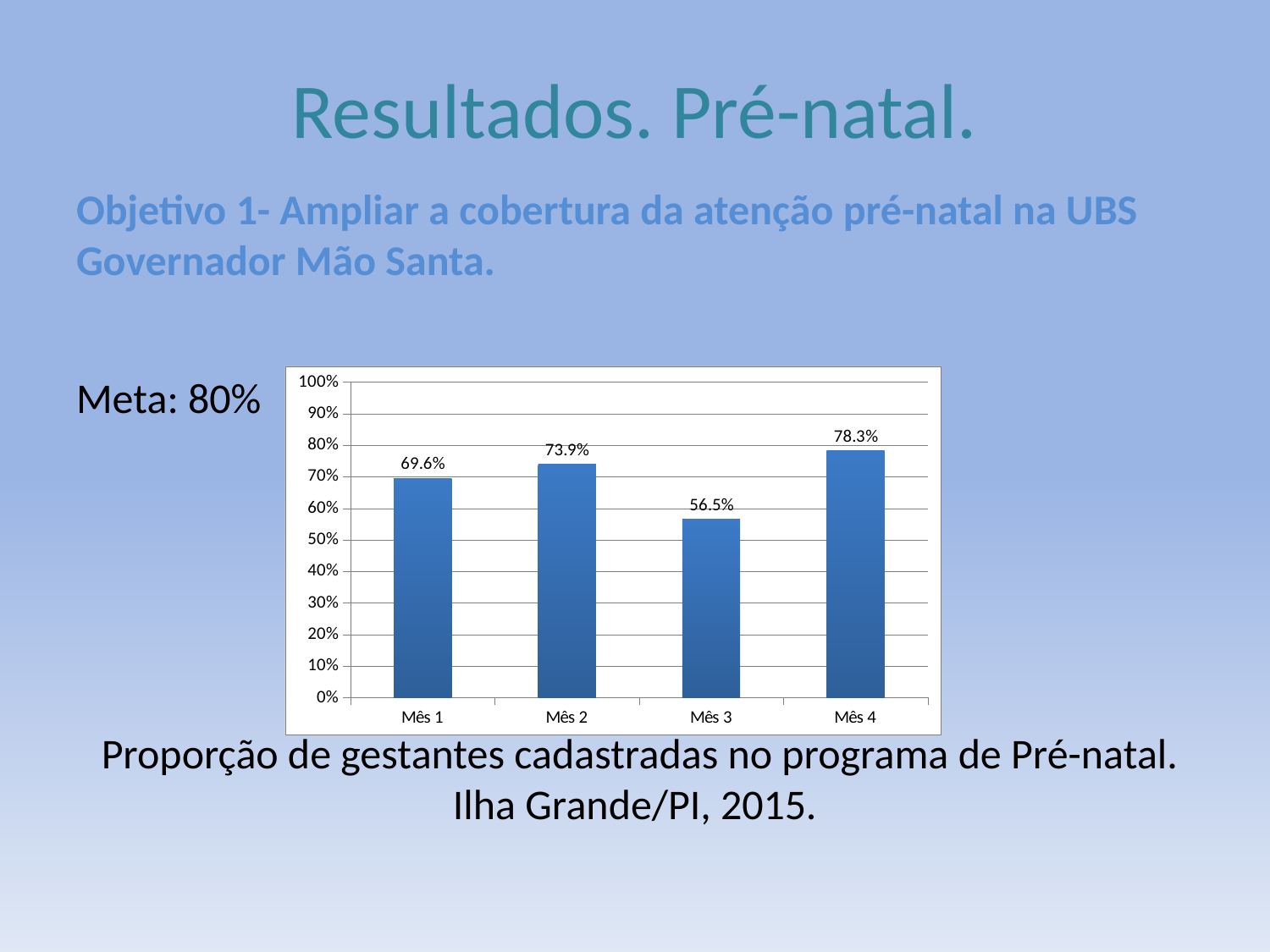
What is the difference between the values for Mês 2 and Mês 1? 4.3% Is the value for Mês 4 greater or less than 80%? less How many months are shown on the x axis? 4 What is the value for Mês 4? 78.3% What is the value for Mês 1? 69.6% Which is larger, the value for Mês 2 or the value for Mês 3? Mês 2 What is the difference between the values for Mês 4 and Mês 3? 21.8% Which month has the highest value? Mês 4 What target (Meta) is stated next to the chart? 80% Which month has the lowest value? Mês 3 What kind of chart is shown on the slide? bar chart What is the value for Mês 3? 56.5%